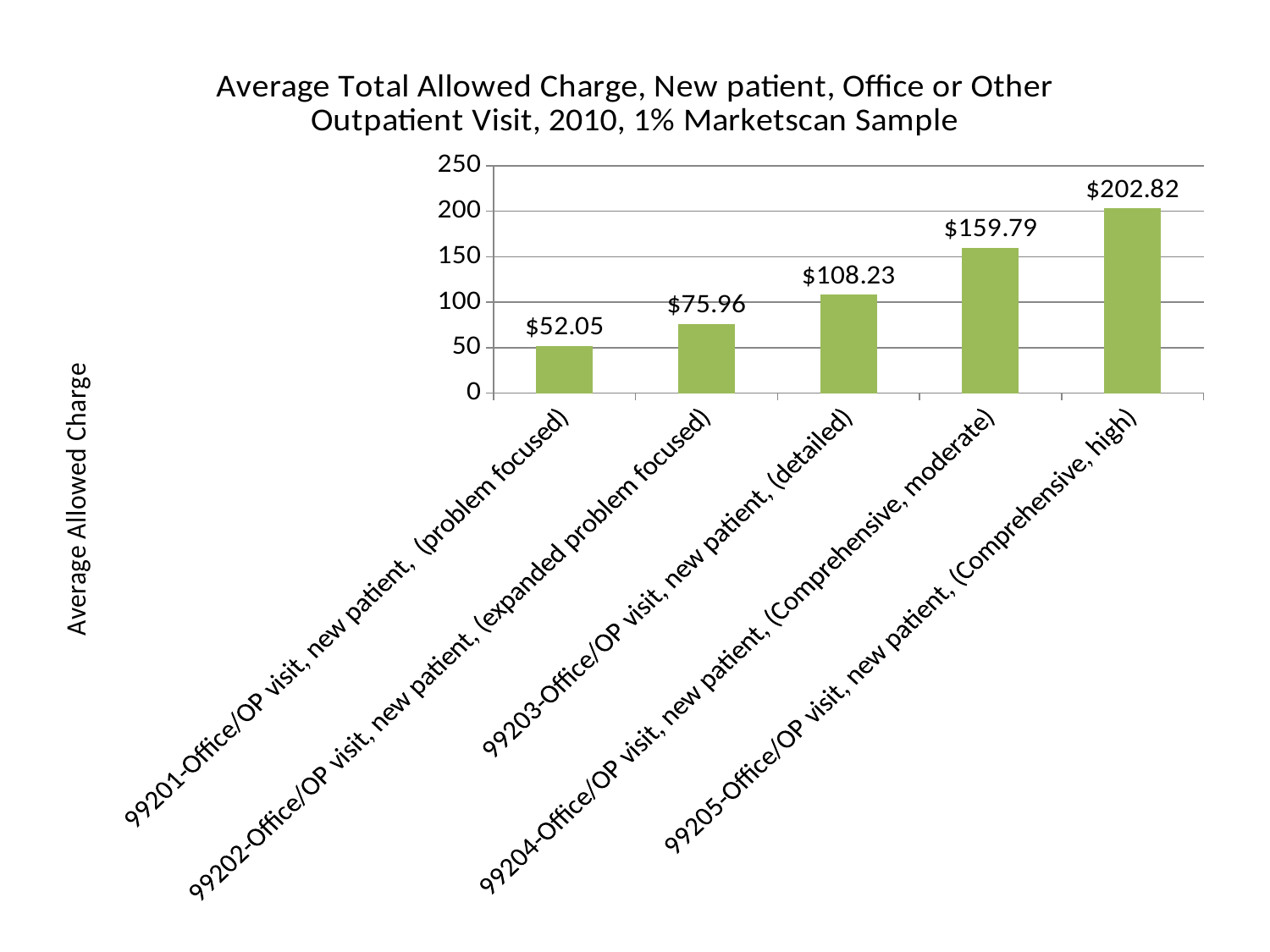
What is the average allowed charge for 99203-Office/OP visit, new patient, (detailed)? $108.23 Do the values rise or fall moving from left to right along the x axis? rise What is the difference between the average allowed charge for 99204 (Comprehensive, moderate) and 99202 (expanded problem focused)? $83.83 Is the value for 99204-Office/OP visit, new patient, (Comprehensive, moderate) greater or less than 150? greater What is the average allowed charge for 99201-Office/OP visit, new patient, (problem focused)? $52.05 What is the label of the vertical axis? Average Allowed Charge Which category has the lowest average allowed charge? 99201-Office/OP visit, new patient, (problem focused) What kind of chart is shown on the slide? bar chart Which has a larger average allowed charge, 99203 (detailed) or 99202 (expanded problem focused)? 99203-Office/OP visit, new patient, (detailed) What is the average allowed charge for 99205-Office/OP visit, new patient, (Comprehensive, high)? $202.82 How many categories are shown on the chart? 5 Which category has the highest average allowed charge? 99205-Office/OP visit, new patient, (Comprehensive, high)